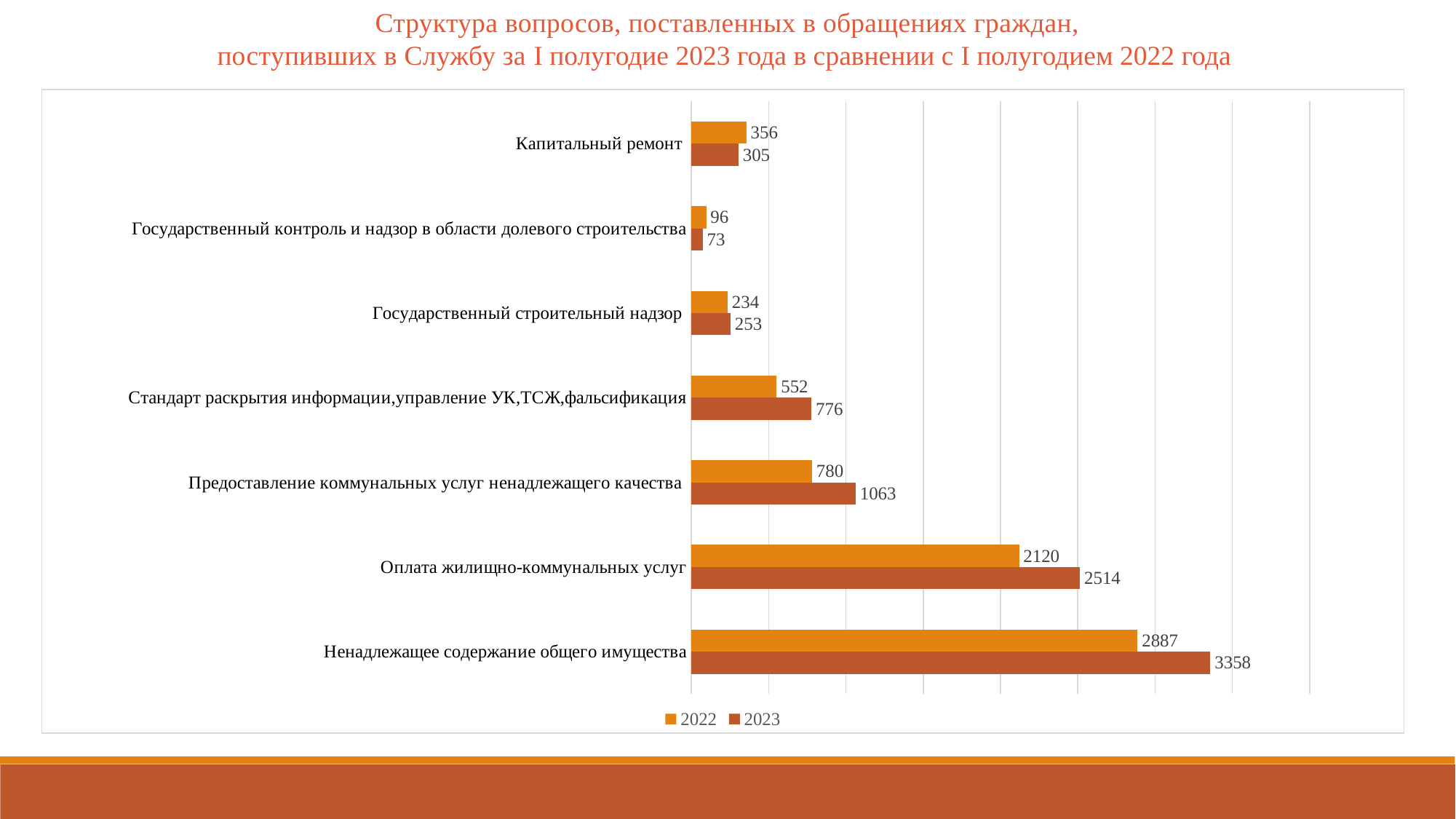
How many series does the legend list? 2 What is the difference between the 2023 and 2022 values for "Предоставление коммунальных услуг ненадлежащего качества"? 283 What is the value for 2022 for "Оплата жилищно-коммунальных услуг"? 2120 How many categories are shown on the chart? 7 Which series is shown in the darker brown colour? 2023 What is the value for 2023 for "Государственный контроль и надзор в области долевого строительства"? 73 Which category has the lowest value for 2023? Государственный контроль и надзор в области долевого строительства For "Капитальный ремонт", which year has the larger value, 2022 or 2023? 2022 Which category has the highest value for 2022? Ненадлежащее содержание общего имущества For "Государственный строительный надзор", which year has the larger value, 2022 or 2023? 2023 What kind of chart is shown on the slide? Bar chart What is the value for 2023 for "Ненадлежащее содержание общего имущества"? 3358